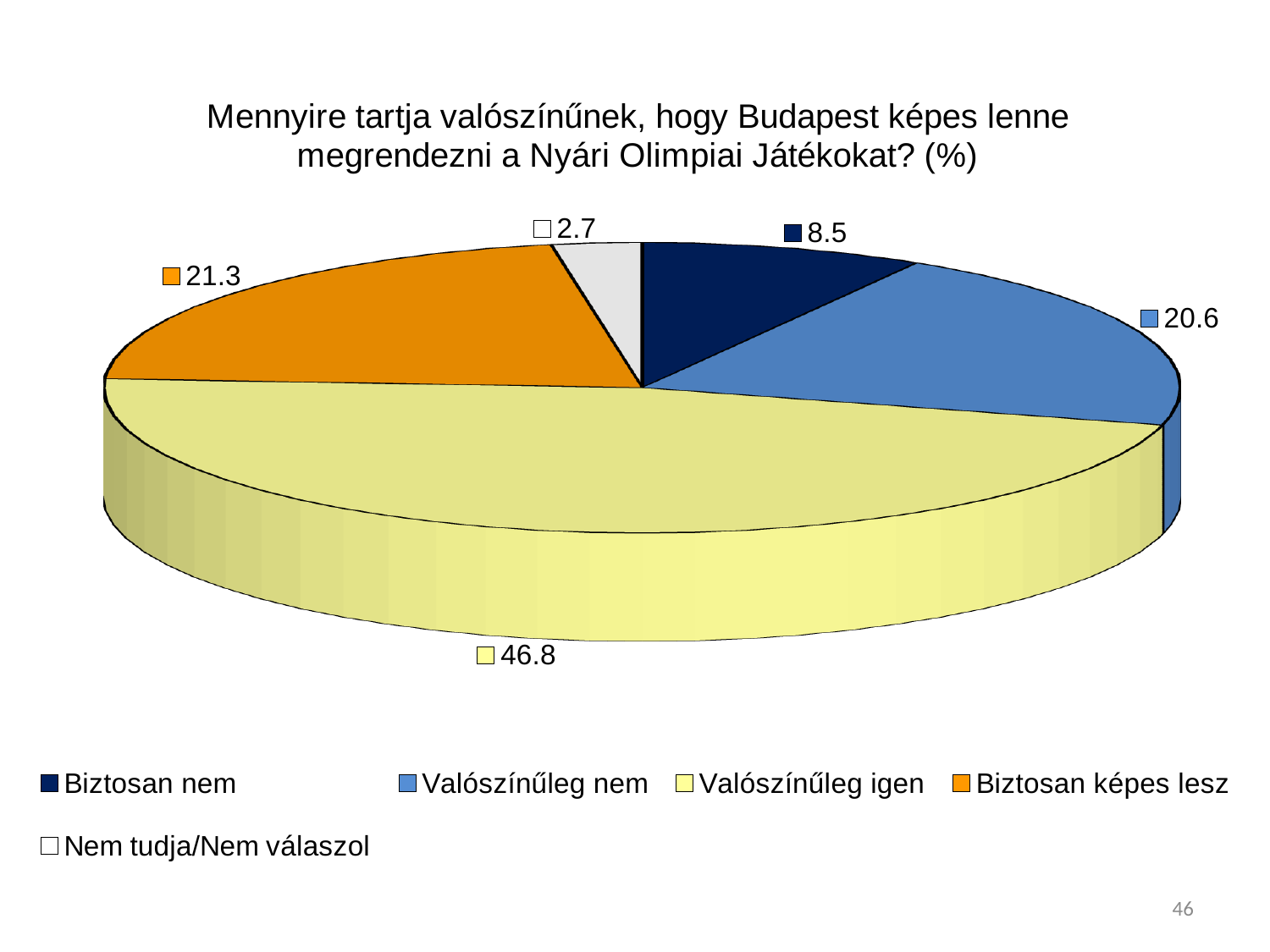
What is the difference between the values for "Valószínűleg nem" and "Biztosan nem"? 12.1 Which is larger, the value for "Valószínűleg nem" or the value for "Biztosan nem"? Valószínűleg nem Which colour is used for the "Biztosan képes lesz" slice? Orange How many categories does the pie chart show? 5 Which category has the smallest slice of the pie? Nem tudja/Nem válaszol What is the difference between the values for "Valószínűleg igen" and "Biztosan képes lesz"? 25.5 What value is shown for the "Biztosan nem" slice? 8.5 Which category has the largest slice of the pie? Valószínűleg igen What kind of chart is shown on the slide? Pie chart What value is shown for the "Valószínűleg igen" slice? 46.8 What value is shown for the "Nem tudja/Nem válaszol" slice? 2.7 What value is shown for the "Biztosan képes lesz" slice? 21.3